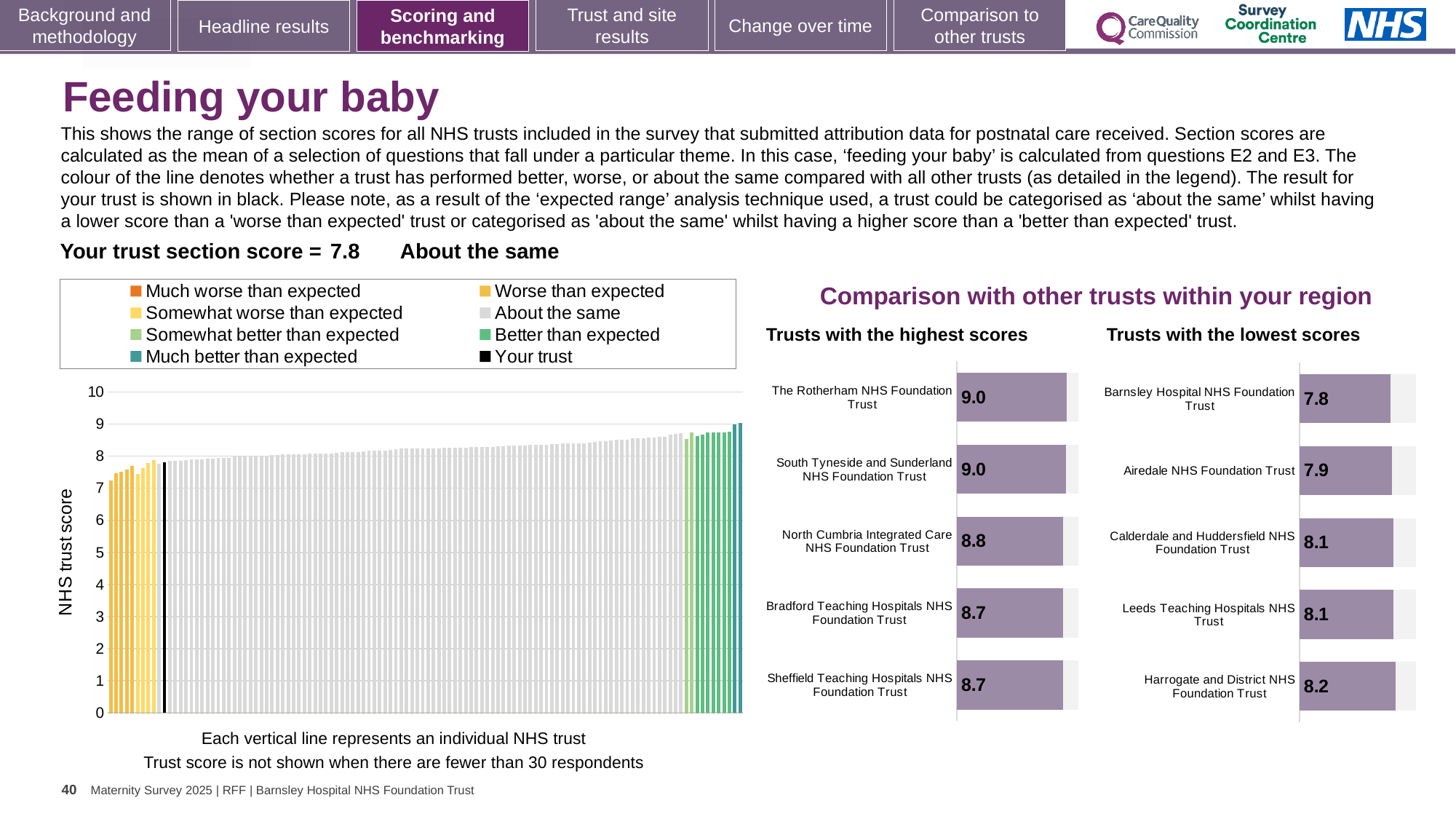
In the 'Trusts with the lowest scores' chart, what is the score for Airedale NHS Foundation Trust? 7.9 In the 'Trusts with the lowest scores' chart, which trust has the lowest score? Barnsley Hospital NHS Foundation Trust How many entries does the legend of the NHS trust score chart list? 8 In the NHS trust score chart on the left, do the bar values rise or fall from left to right? Rise In the 'Trusts with the highest scores' chart, what is the difference between the scores of The Rotherham NHS Foundation Trust and North Cumbria Integrated Care NHS Foundation Trust? 0.2 What kind of chart is the NHS trust score chart on the left? Bar chart In the NHS trust score chart on the left, is the value of the lowest bar greater or less than 7? greater In the 'Trusts with the lowest scores' chart, what is the difference between the scores of Harrogate and District NHS Foundation Trust and Barnsley Hospital NHS Foundation Trust? 0.4 How many trusts are listed in the 'Trusts with the highest scores' chart? 5 In the 'Trusts with the lowest scores' chart, which trust has the highest score? Harrogate and District NHS Foundation Trust In the 'Trusts with the highest scores' chart, what is the score for North Cumbria Integrated Care NHS Foundation Trust? 8.8 In the 'Trusts with the lowest scores' chart, which has the higher score: Airedale NHS Foundation Trust or Calderdale and Huddersfield NHS Foundation Trust? Calderdale and Huddersfield NHS Foundation Trust